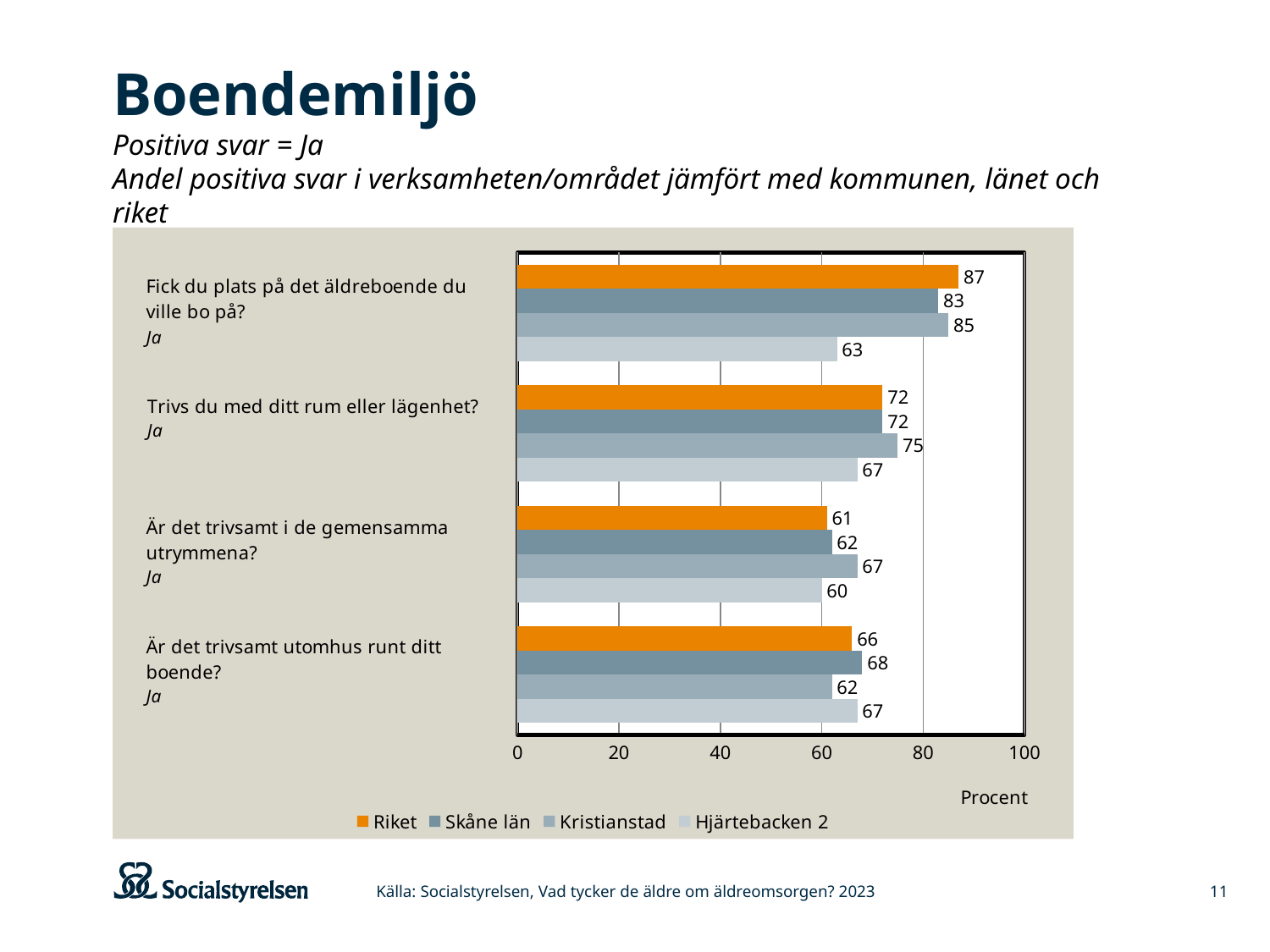
What kind of chart is shown on the slide? Bar chart What is the value for Hjärtebacken 2 on "Fick du plats på det äldreboende du ville bo på?"? 63 Which series has the highest value on "Fick du plats på det äldreboende du ville bo på?"? Riket What is the value for Kristianstad on "Är det trivsamt i de gemensamma utrymmena?"? 67 What is the value for Riket on "Trivs du med ditt rum eller lägenhet?"? 72 How many question categories are shown in the chart? 4 What is the value for Skåne län on "Är det trivsamt utomhus runt ditt boende?"? 68 What is the difference between Riket and Hjärtebacken 2 on "Fick du plats på det äldreboende du ville bo på?"? 24 Is the value for Kristianstad on "Trivs du med ditt rum eller lägenhet?" greater or less than 60? greater Which is larger on "Är det trivsamt utomhus runt ditt boende?": Kristianstad or Hjärtebacken 2? Hjärtebacken 2 Which series has the lowest value on "Är det trivsamt i de gemensamma utrymmena?"? Hjärtebacken 2 How many series does the legend list? 4